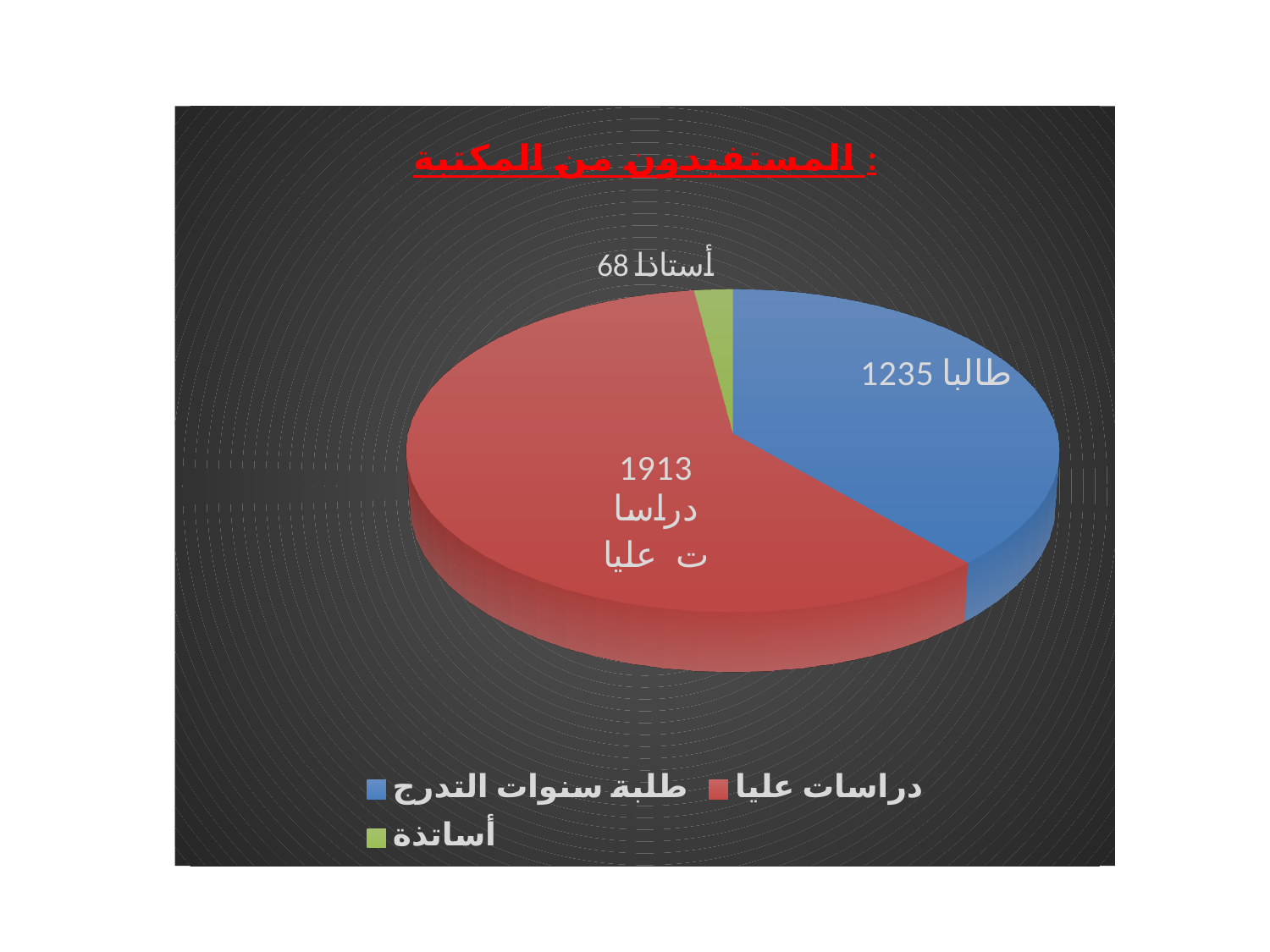
Which category has the smallest slice of the pie? أساتذة Which is larger, the value for دراسات عليا or the value for طلبة سنوات التدرج? دراسات عليا How many slices does the pie chart have? 3 Which category has the largest slice of the pie? دراسات عليا What is the value shown for the دراسات عليا slice? 1913 What is the value shown for the طلبة سنوات التدرج slice (labelled طالبا)? 1235 How many entries does the legend list? 3 What is the difference between the طلبة سنوات التدرج value (1235) and the أساتذة value (68)? 1167 What is the difference between the دراسات عليا value and the طلبة سنوات التدرج value? 678 What colour is the slice for أساتذة? green What is the value shown for the أساتذة slice? 68 What kind of chart is shown on the slide? pie chart